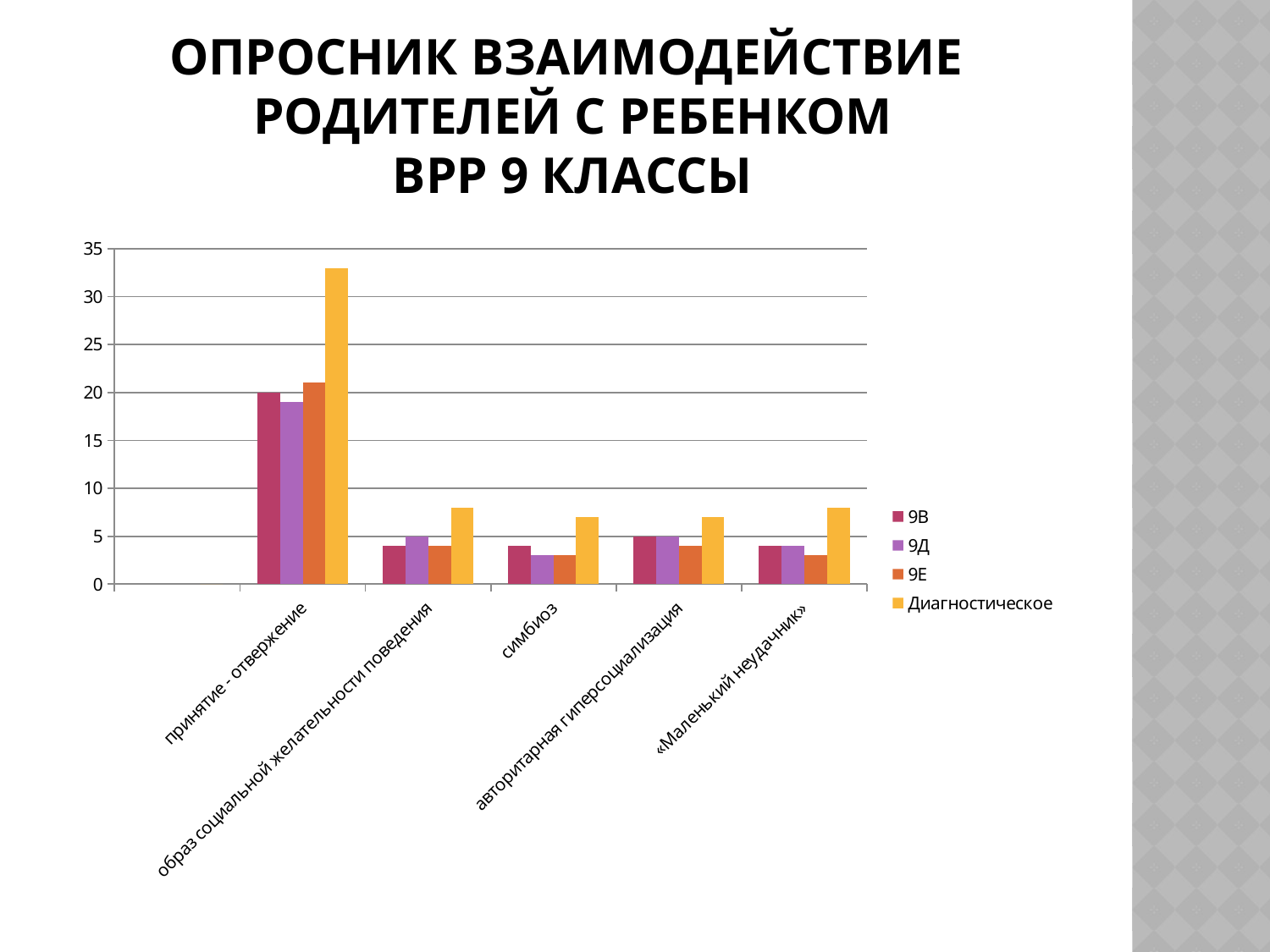
What kind of chart is shown on the slide? bar chart Which series has the highest value for принятие - отвержение? Диагностическое What is the value for 9В in the принятие - отвержение category? 20 Which category has the highest value for the Диагностическое series? принятие - отвержение How many categories are shown on the x axis? 5 How many series does the legend list? 4 Which is larger in the принятие - отвержение category: 9Е or 9Д? 9Е Is the value for Диагностическое in the принятие - отвержение category greater or less than 30? greater Which series is shown in yellow in the legend? Диагностическое Is the value for 9Е in the симбиоз category greater or less than 5? less What is the value for 9В in the авторитарная гиперсоциализация category? 5 Which is larger in the образ социальной желательности поведения category: Диагностическое or 9Д? Диагностическое